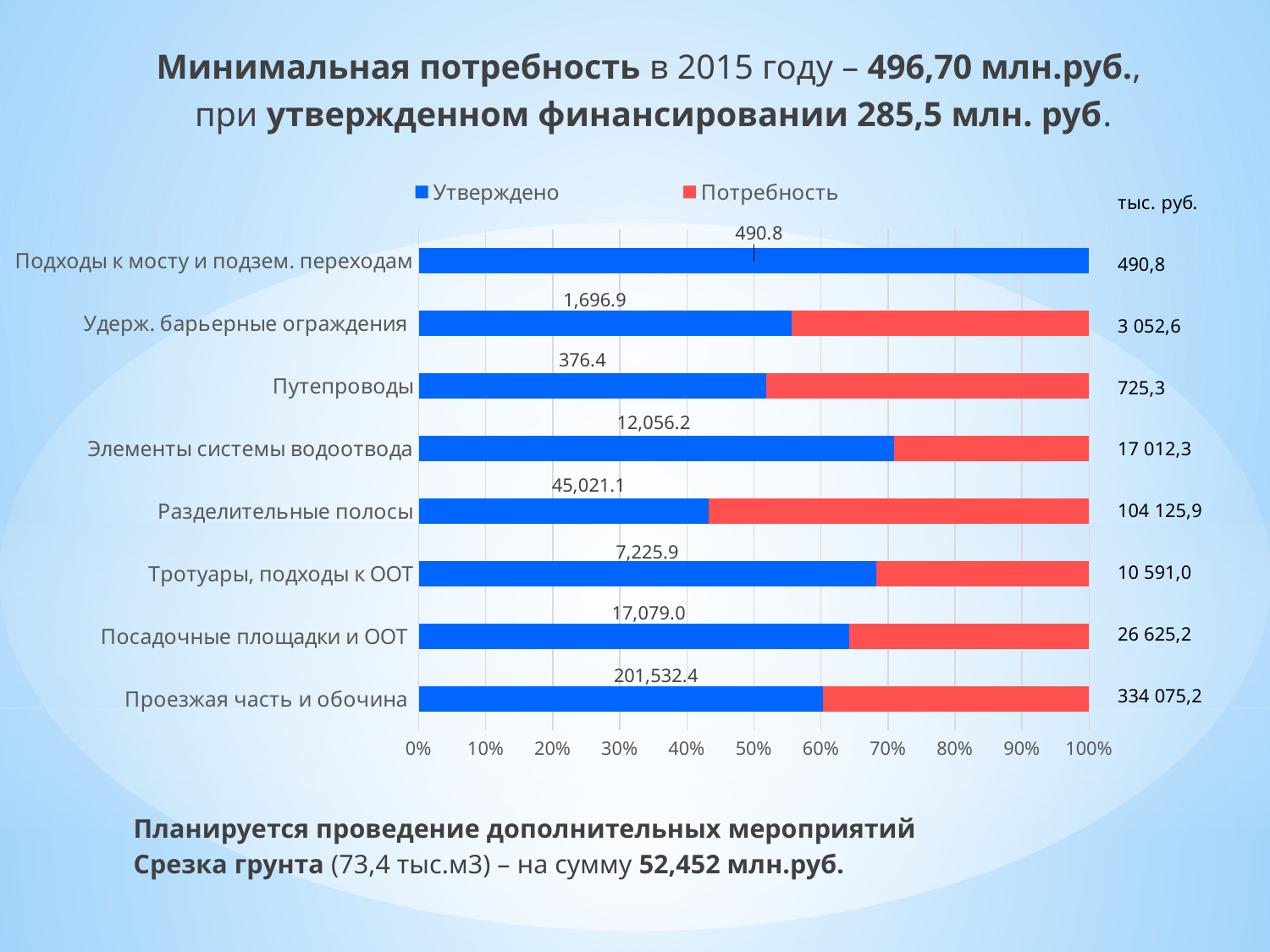
Which category has the highest labelled Утверждено value? Проезжая часть и обочина How many categories are plotted on the chart? 8 What is the Утверждено value labelled for Путепроводы? 376.4 What kind of chart is shown on the slide? bar chart What is the Утверждено value labelled for Разделительные полосы? 45,021.1 How many series does the chart legend list? 2 Which has the larger Утверждено value: Элементы системы водоотвода or Тротуары, подходы к ООТ? Элементы системы водоотвода What is the difference between the Утверждено values for Посадочные площадки и ООТ and Тротуары, подходы к ООТ? 9,853.1 What is the Утверждено value labelled for Проезжая часть и обочина? 201,532.4 Is the Утверждено share of the bar for Разделительные полосы greater or less than 50%? less Which colour represents the Потребность series in the chart? red Which category has the lowest labelled Утверждено value? Путепроводы